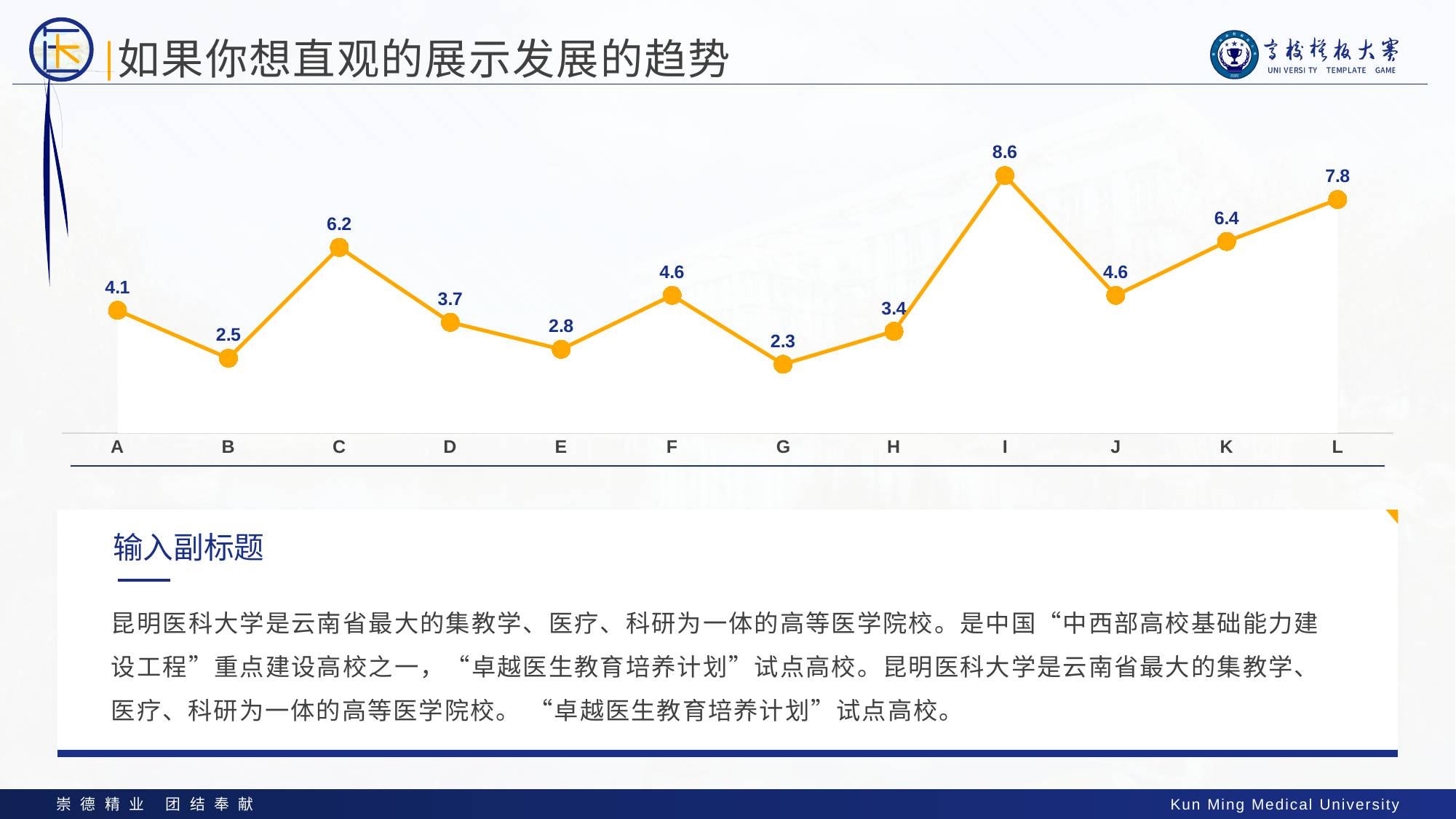
Which is larger, the value for A or the value for B? A What is the difference between the values for I and G? 6.3 Which category has the highest value? I Which is larger, the value for K or the value for L? L What is the value for category C? 6.2 How many categories are shown on the x axis? 12 What kind of chart is shown on the slide? line chart Which category has the lowest value? G Do the values rise or fall from I to J? fall What is the value for category I? 8.6 What is the value for category L? 7.8 What is the difference between the values for C and D? 2.5